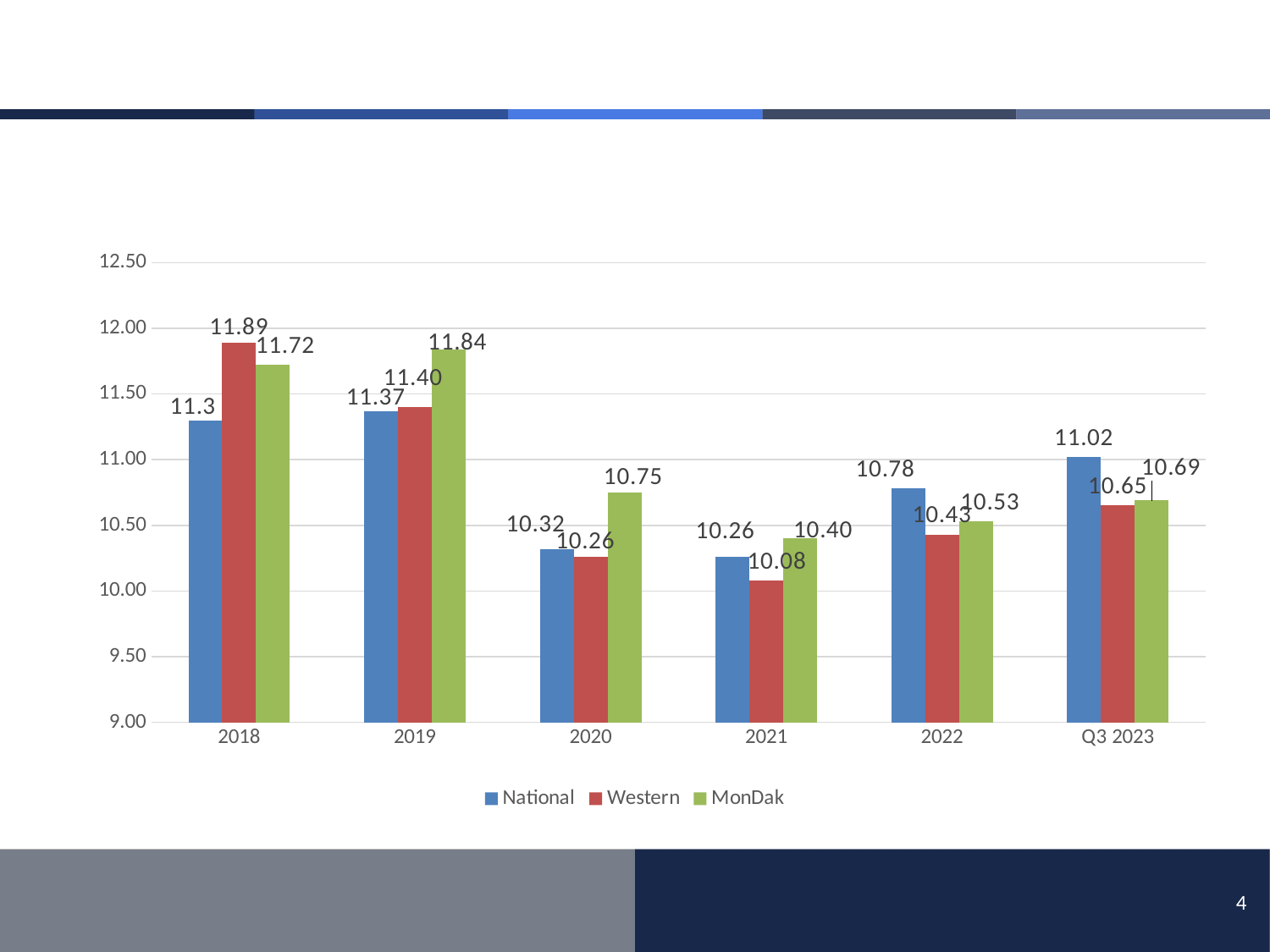
Which series is shown in green in the legend? MonDak What is the value for National in Q3 2023? 11.02 Which is larger in 2022, National or MonDak? National What is the difference between the MonDak and Western values in 2020? 0.49 In which year is the MonDak series highest? 2019 What kind of chart is shown on the slide? Bar chart What is the value for Western in 2021? 10.08 How many categories are shown on the x axis? 6 How many series does the legend list? 3 What is the value for MonDak in 2019? 11.84 What is the value for Western in 2018? 11.89 In which year is the Western series lowest? 2021